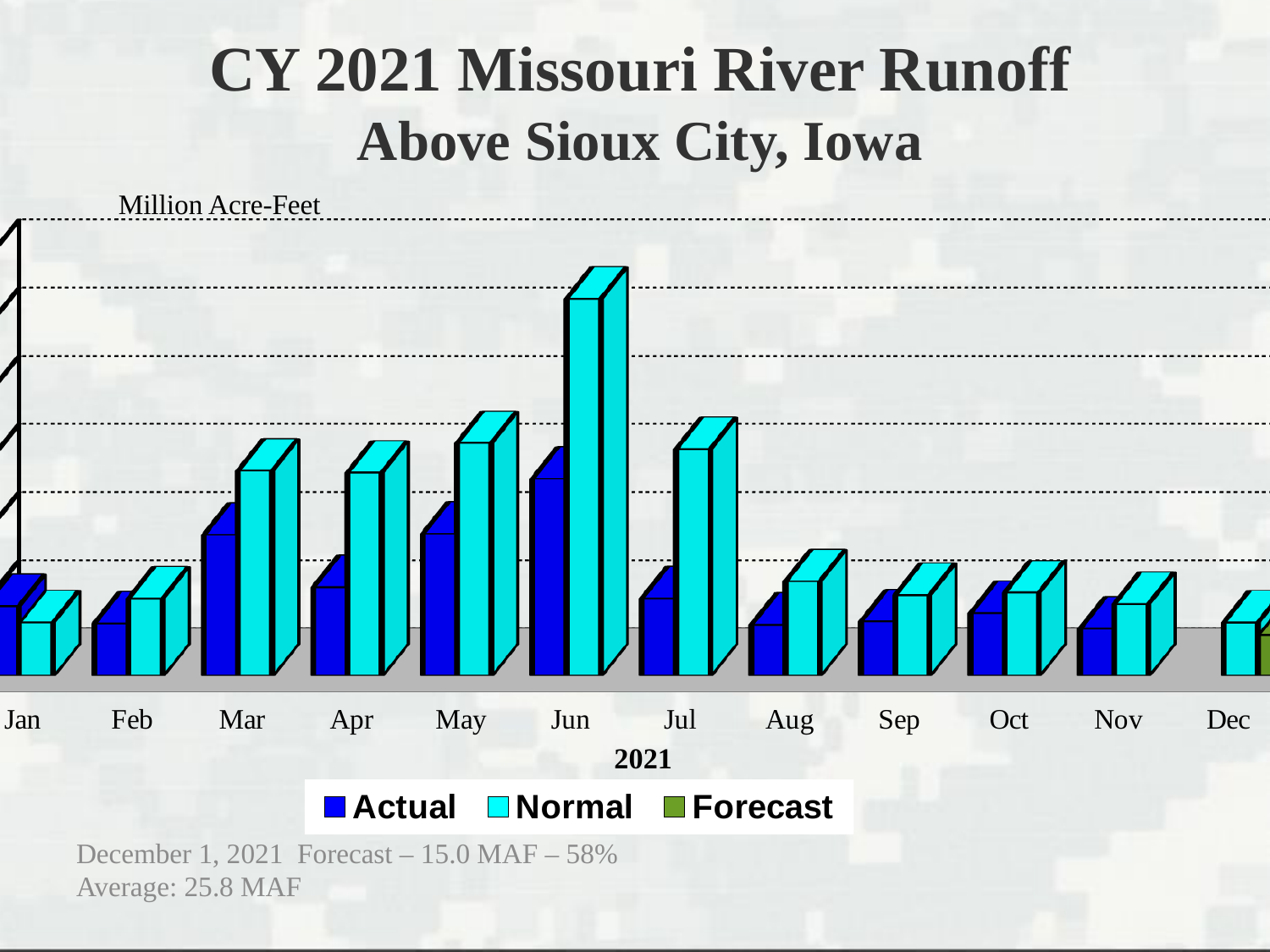
What unit label is shown above the y axis of the chart? Million Acre-Feet Which series in the legend is shown in green? Forecast Which month has the larger Actual runoff, Jan or Mar? Mar In which month is the Actual runoff highest? Jun How many months are shown along the x axis of the chart? 12 In which month is the Normal runoff highest? Jun Do the Normal runoff values rise or fall from Jun to Sep? fall How many series does the chart legend list? 3 In June, which is larger, the Actual runoff or the Normal runoff? Normal Which month has the larger Normal runoff, Jul or Aug? Jul What kind of chart is shown on the slide? bar chart